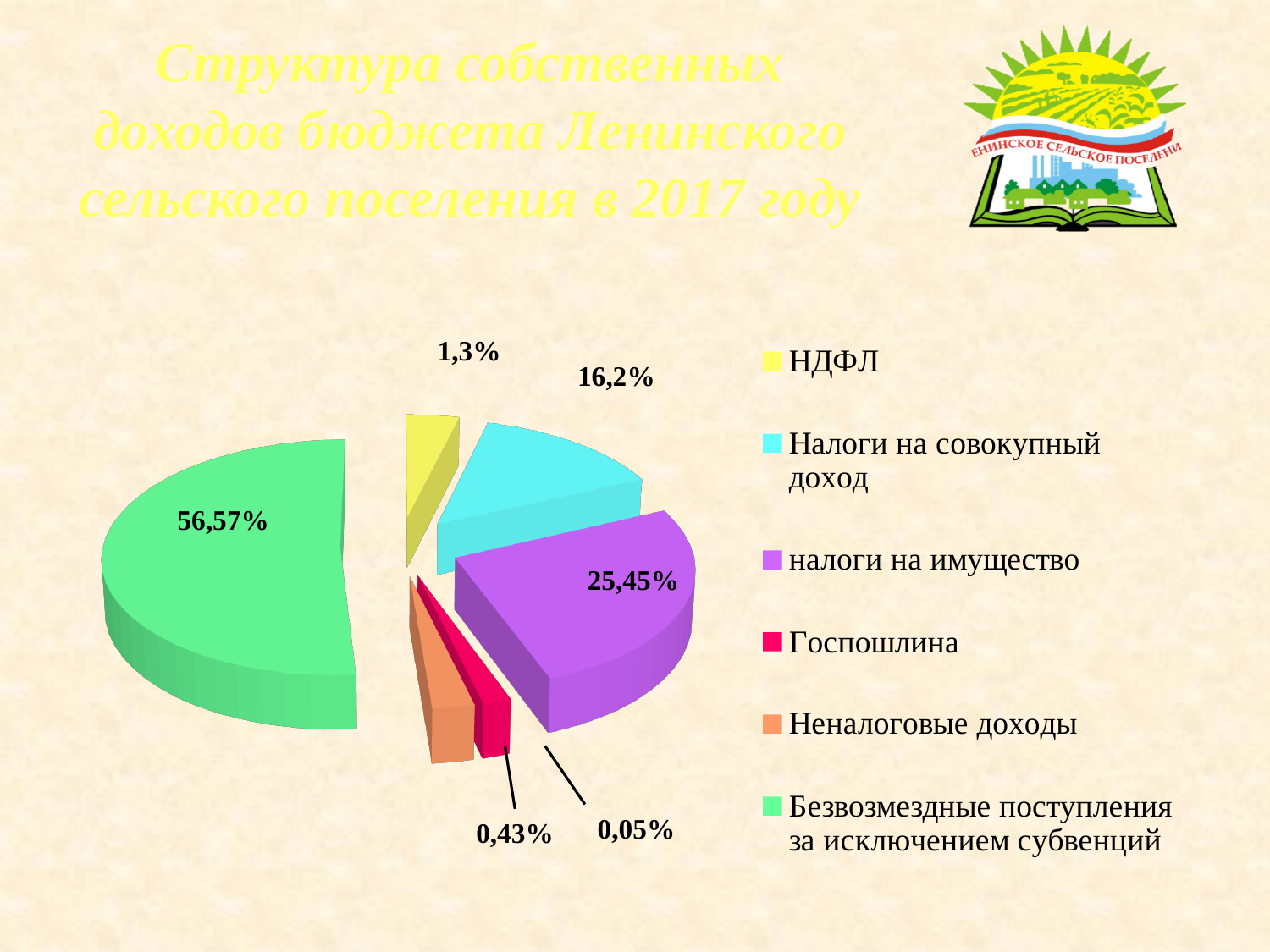
What share of the pie is labelled for Безвозмездные поступления за исключением субвенций? 56,57% Which is larger: the share for налоги на имущество or the share for Налоги на совокупный доход? налоги на имущество Is the share for Безвозмездные поступления за исключением субвенций greater or less than 50%? greater What colour is the НДФЛ slice in the pie chart? Yellow What share of the pie is labelled for НДФЛ? 1,3% What is the difference between the share for Безвозмездные поступления за исключением субвенций and the share for налоги на имущество? 31,12% What kind of chart is shown on the slide? Pie chart What share of the pie is labelled for Налоги на совокупный доход? 16,2% How many categories does the pie chart's legend list? 6 What share of the pie is labelled for налоги на имущество? 25,45% What is the difference between the share for налоги на имущество and the share for Налоги на совокупный доход? 9,25% Which category has the largest slice of the pie? Безвозмездные поступления за исключением субвенций